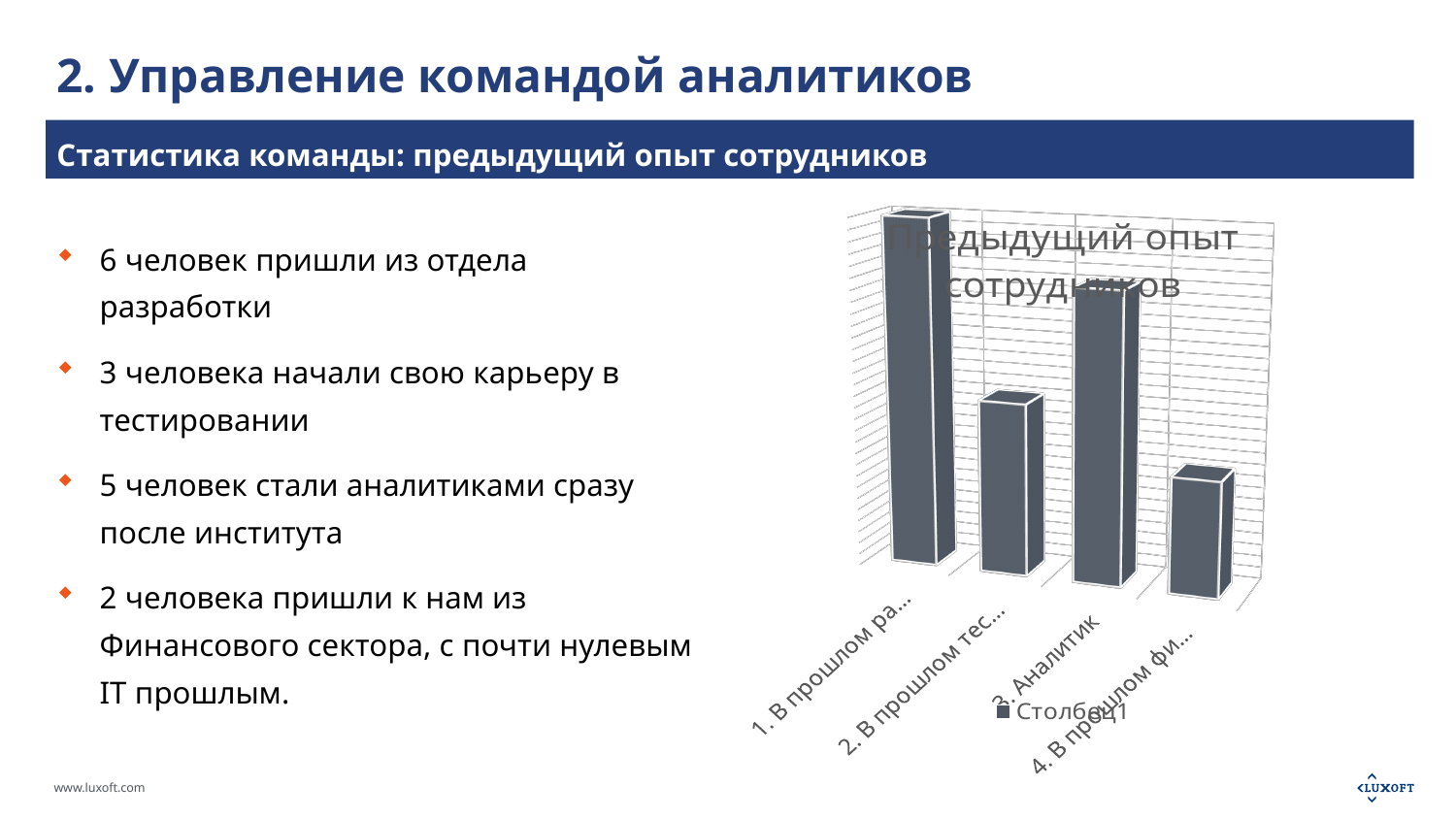
What is the name of the series shown in the chart legend? Столбец1 How many series does the chart legend list? 1 Which bar is taller: the one for "3. Аналитик" or the one for "2. В прошлом тес..."? 3. Аналитик Which category is the third bar from the left in the chart? 3. Аналитик What is the title of the chart? Предыдущий опыт сотрудников Which category has the tallest bar in the chart? 1. В прошлом ра... Which category has the shortest bar in the chart? 4. В прошлом фи... Which bar is taller: the first bar ("1. В прошлом ра...") or the third bar ("3. Аналитик")? 1. В прошлом ра... What kind of chart is shown on the slide? bar chart Which bar is shorter: the one for "2. В прошлом тес..." or the one for "4. В прошлом фи..."? 4. В прошлом фи... How many categories (bars) does the chart show? 4